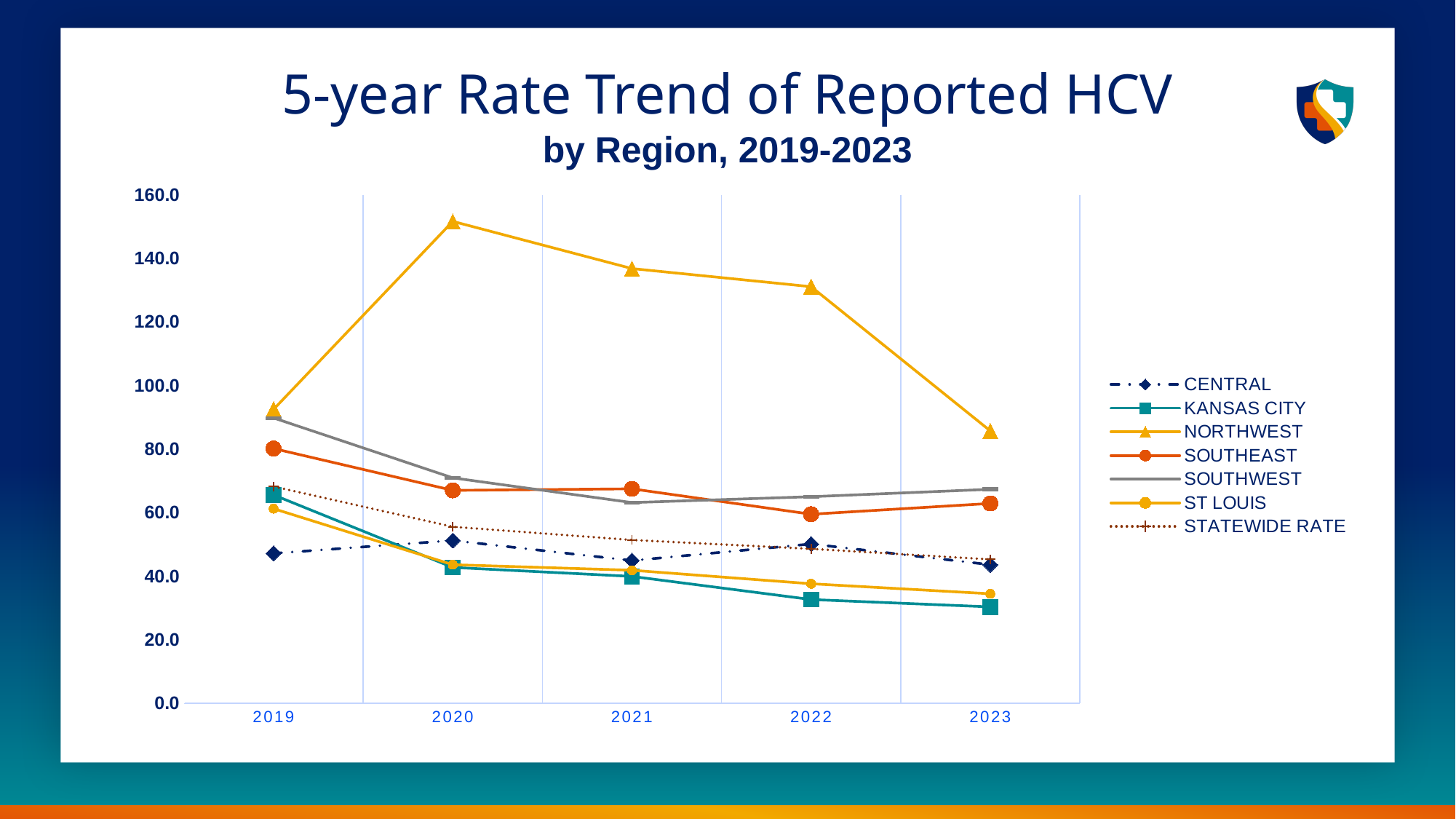
In 2019, which is larger: the SOUTHEAST rate or the SOUTHWEST rate? SOUTHWEST Is the SOUTHWEST value for 2023 greater or less than 60.0? greater Which region has the lowest rate in 2023? KANSAS CITY Which region has the lowest rate in 2019? CENTRAL Is the KANSAS CITY value for 2023 greater or less than 40.0? less Is the NORTHWEST value for 2020 greater or less than 140.0? greater How many years are plotted along the x axis? 5 What is the title of the chart? 5-year Rate Trend of Reported HCV by Region, 2019-2023 Does the NORTHWEST rate rise or fall from 2020 to 2023? fall Which region has the highest rate in 2020? NORTHWEST How many series does the legend list? 7 What kind of chart is shown on the slide? line chart